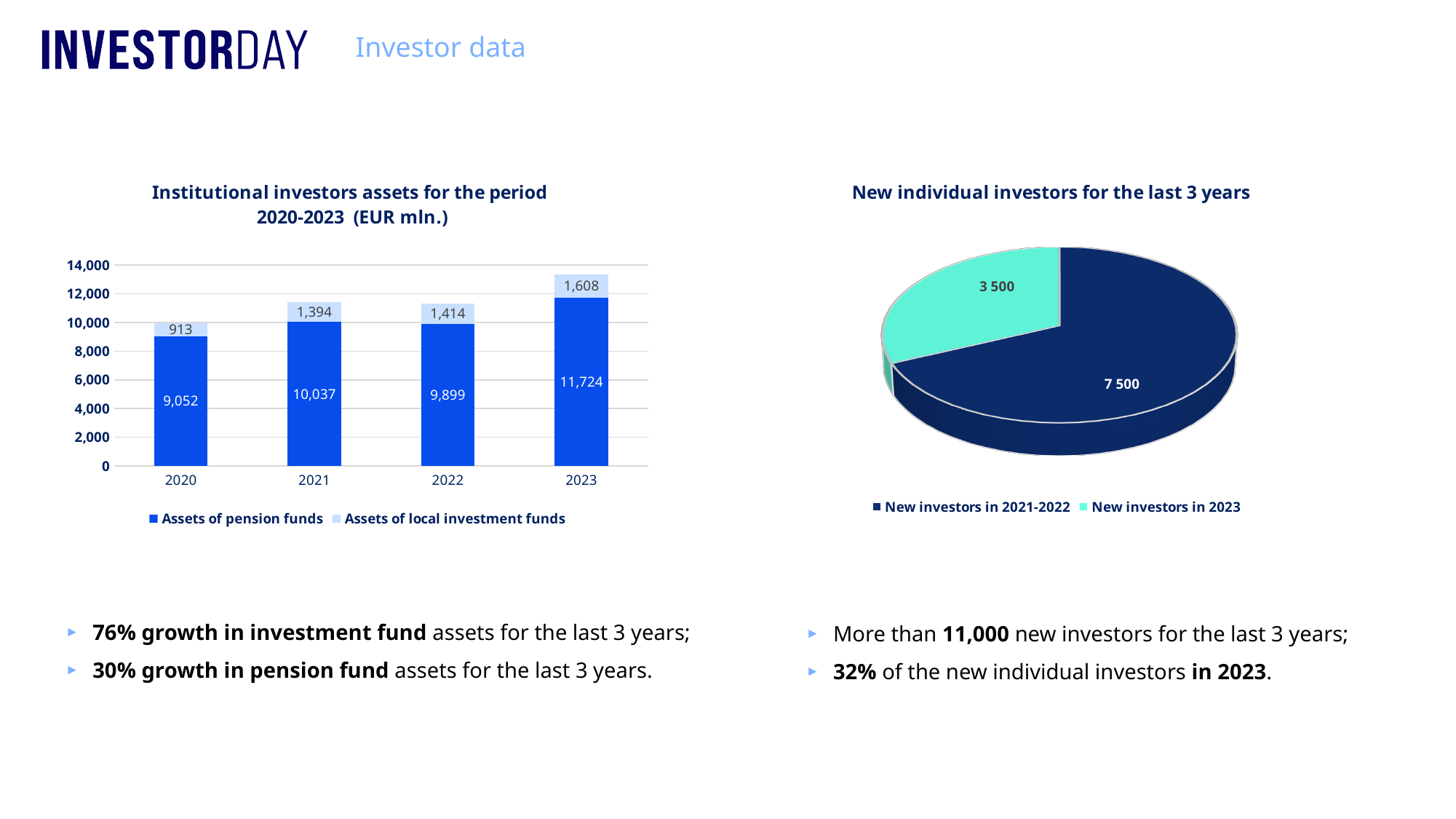
In the 'Institutional investors assets' chart, which year has the lowest value for Assets of local investment funds? 2020 In the 'Institutional investors assets' chart, which year has the highest value for Assets of pension funds? 2023 In the 'Institutional investors assets' chart, how many series does the legend list? 2 In the 'Institutional investors assets' chart, what is the value for Assets of pension funds in 2023? 11,724 In the 'Institutional investors assets' chart, what is the value for Assets of local investment funds in 2021? 1,394 In the 'New individual investors for the last 3 years' chart, what is the value for New investors in 2021-2022? 7 500 In the 'Institutional investors assets' chart, how many years are shown on the x axis? 4 In the 'New individual investors for the last 3 years' chart, what is the difference between New investors in 2021-2022 and New investors in 2023? 4 000 In the 'New individual investors for the last 3 years' chart, which slice is larger: New investors in 2021-2022 or New investors in 2023? New investors in 2021-2022 In the 'Institutional investors assets' chart, what is the total of the stacked bar for 2023? 13,332 In the 'Institutional investors assets' chart, what is the difference between Assets of pension funds in 2023 and in 2020? 2,672 What kind of chart is 'New individual investors for the last 3 years'? Pie chart